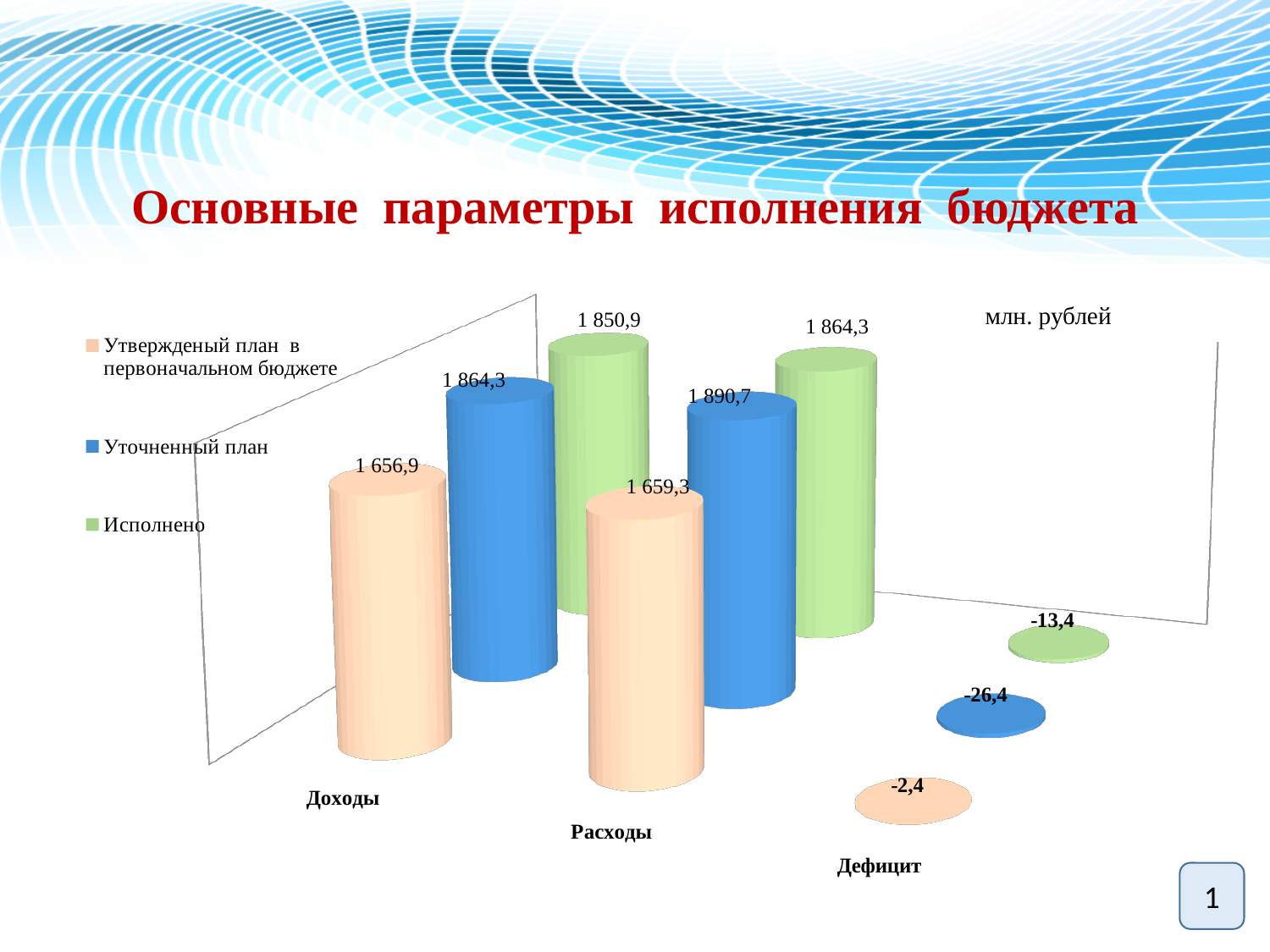
What is the value of Исполнено for Расходы? 1 864,3 What kind of chart is shown on the slide? Bar chart How many series does the legend list? 3 What is the value of Утвержденый план в первоначальном бюджете for Дефицит? -2,4 What unit of measurement is indicated on the chart? млн. рублей Which series has the highest value for Расходы? Уточненный план What is the difference between Уточненный план for Расходы and Уточненный план for Доходы? 26,4 Which is larger: Исполнено for Доходы or Исполнено for Расходы? Исполнено for Расходы What is the value of Исполнено for Доходы? 1 850,9 How many categories are shown on the x axis? 3 Which series has the lowest value for Доходы? Утвержденый план в первоначальном бюджете What is the value of Уточненный план for Доходы? 1 864,3